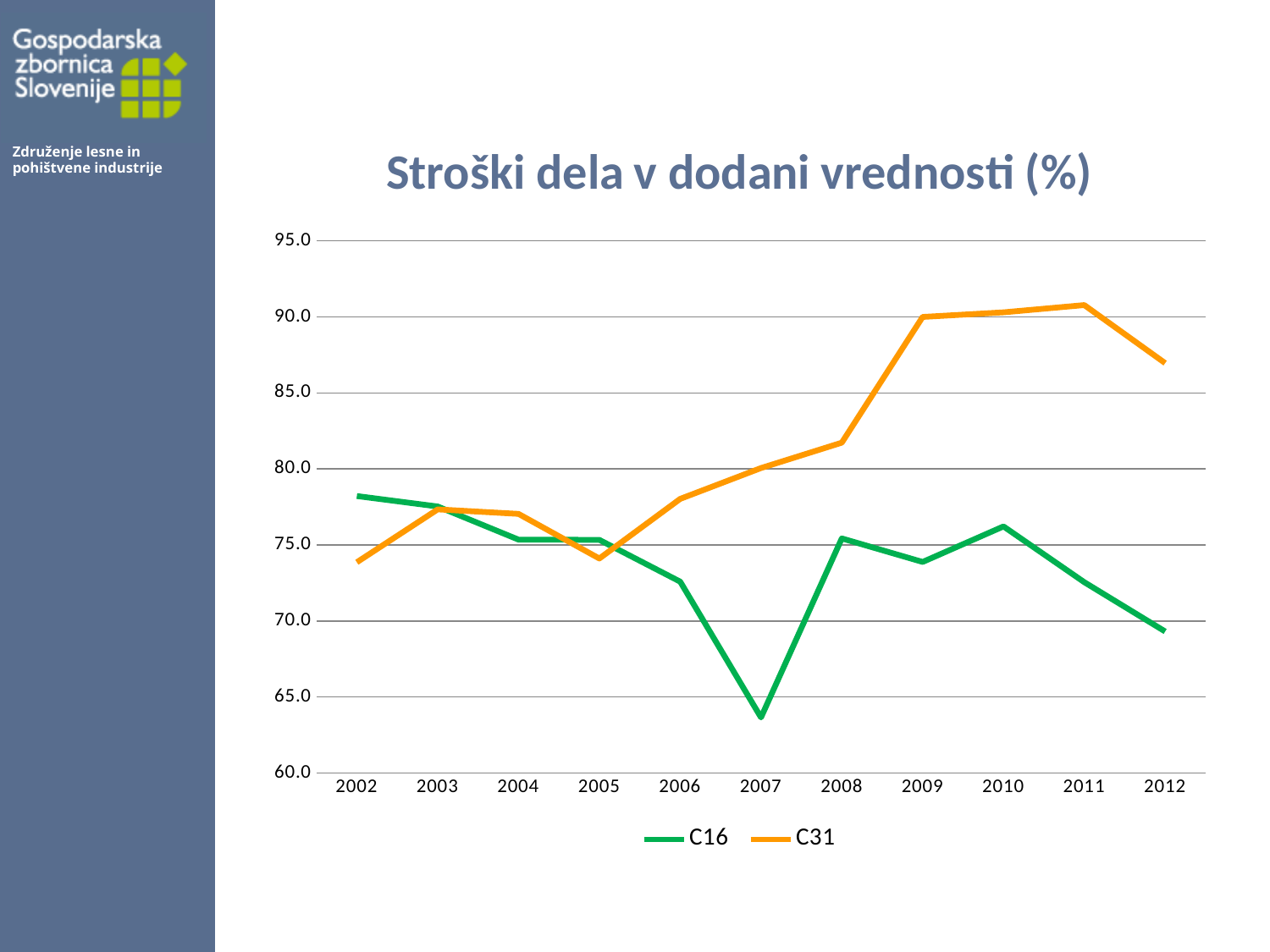
Is the value for C31 in 2011 greater or less than 90.0? greater Is the value for C16 in 2007 greater or less than 65.0? less In which year does the C16 series reach its lowest value? 2007 Is the value for C31 in 2002 greater or less than 75.0? less How many series does the legend list? 2 In 2012, which series has the larger value, C16 or C31? C31 What kind of chart is shown on the slide? line chart In which year does the C31 series reach its highest value? 2011 Does the C31 series rise or fall between 2008 and 2011? rise In 2002, which series has the larger value, C16 or C31? C16 How many years are shown on the x axis? 11